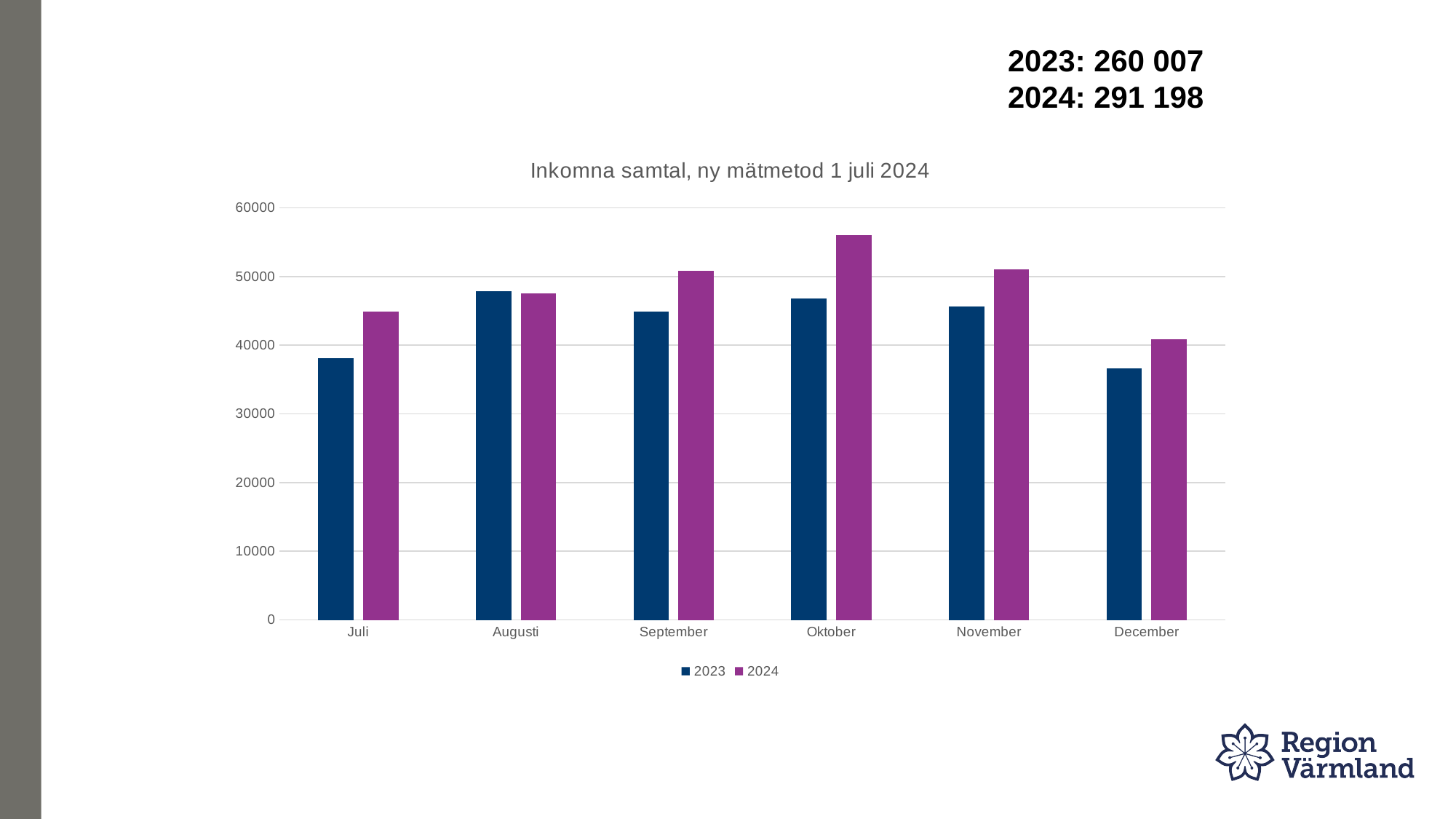
Is the value for Juli in the 2024 series greater or less than 40000? greater Is the value for Juli in the 2023 series greater or less than 40000? less What kind of chart is shown on the slide? bar chart Is the value for Oktober in the 2024 series greater or less than 50000? greater For Oktober, which series has the larger value, 2023 or 2024? 2024 Which month has the lowest value for the 2024 series? December Which month has the lowest value for the 2023 series? December For Juli, which series has the larger value, 2023 or 2024? 2024 What is the title of the chart? Inkomna samtal, ny mätmetod 1 juli 2024 How many series does the legend list? 2 How many months are shown on the x axis? 6 Which month has the highest value for the 2024 series? Oktober